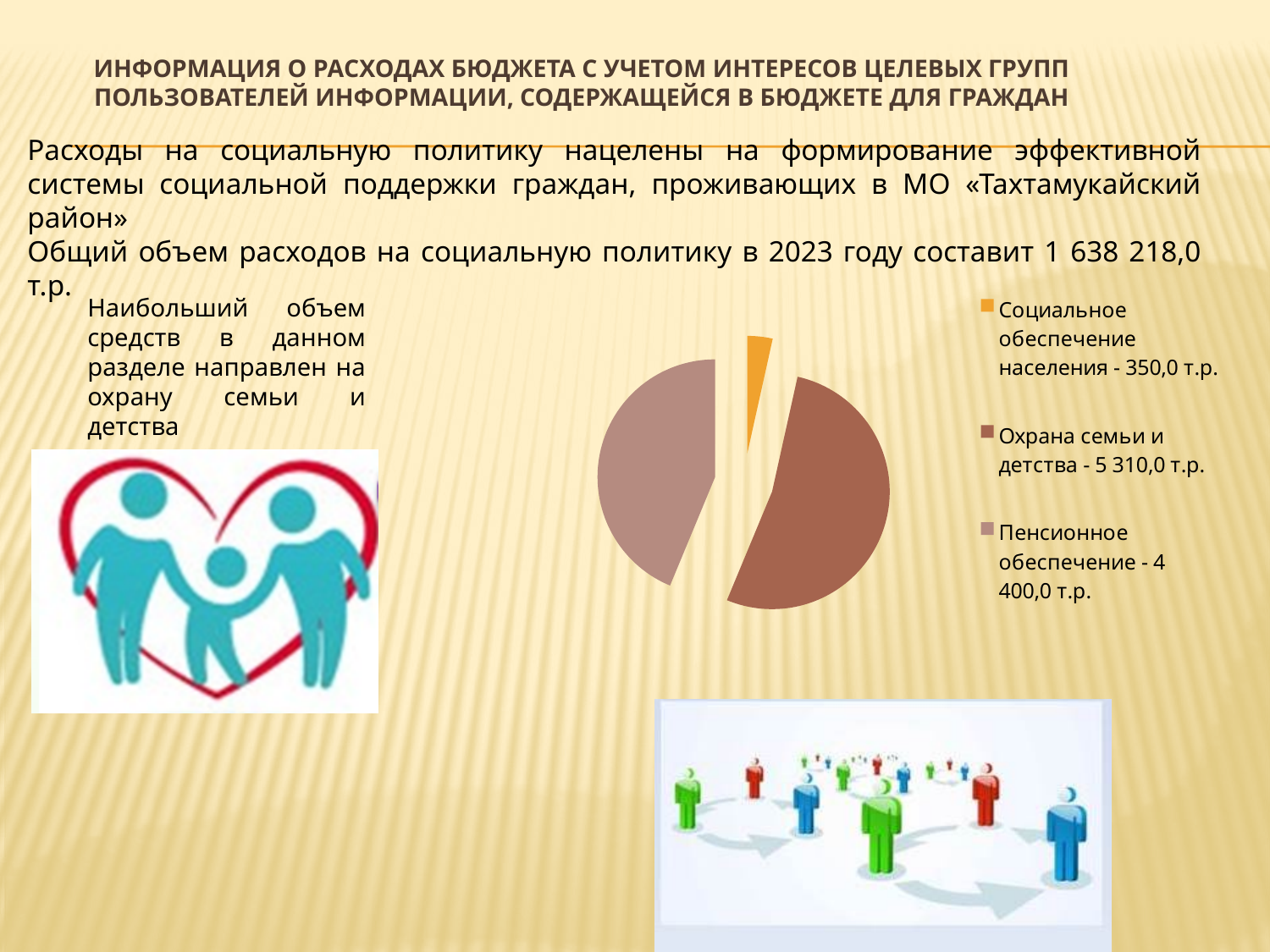
Which category has the largest slice in the pie chart? Охрана семьи и детства What is the value for Социальное обеспечение населения in the pie chart? 350,0 т.р. Which is larger in the pie chart: Охрана семьи и детства or Пенсионное обеспечение? Охрана семьи и детства What is the value for Охрана семьи и детства in the pie chart? 5 310,0 т.р. How many entries does the legend of the pie chart list? 3 What kind of chart is shown on the slide? Pie chart How many slices does the pie chart have? 3 What is the difference between the values for Охрана семьи и детства and Пенсионное обеспечение? 910,0 т.р. What colour is the slice for Социальное обеспечение населения in the pie chart? Orange Which category has the smallest slice in the pie chart? Социальное обеспечение населения What is the total of the three values shown in the pie chart legend? 10 060,0 т.р. What is the value for Пенсионное обеспечение in the pie chart? 4 400,0 т.р.